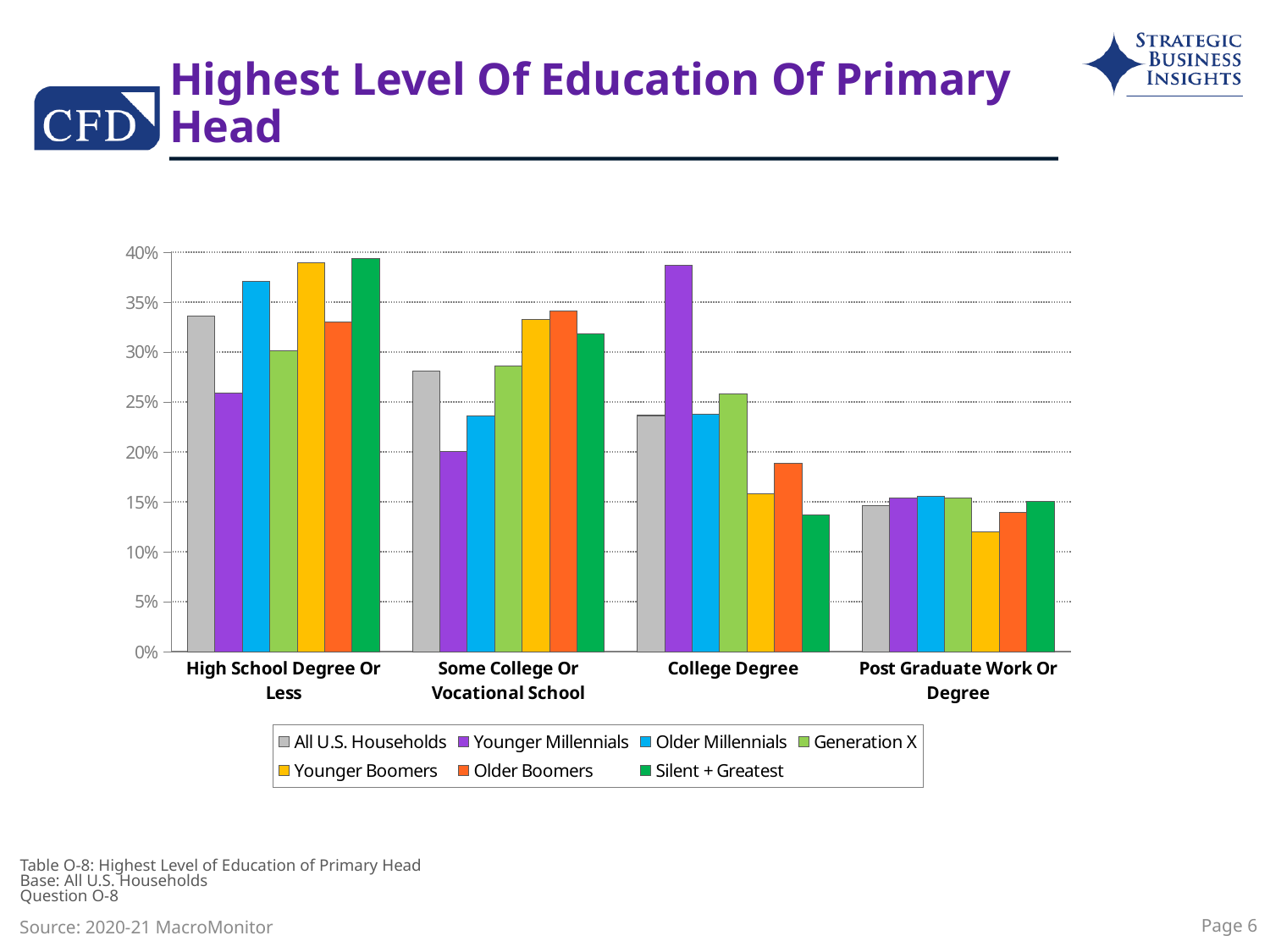
How many series does the legend list? 7 Which series has the highest value in the College Degree category? Younger Millennials In the High School Degree Or Less category, which is larger: Younger Millennials or Older Millennials? Older Millennials What kind of chart is shown on the slide? bar chart How many education-level categories are shown on the x axis? 4 Is the value for Younger Millennials in the Some College Or Vocational School category greater or less than 25%? less Is the value for Younger Millennials in the College Degree category greater or less than 35%? greater In the Some College Or Vocational School category, which is larger: Younger Boomers or Younger Millennials? Younger Boomers Is the value for Silent + Greatest in the High School Degree Or Less category greater or less than 35%? greater Which series is shown in purple in the legend? Younger Millennials Which series has the lowest value in the College Degree category? Silent + Greatest